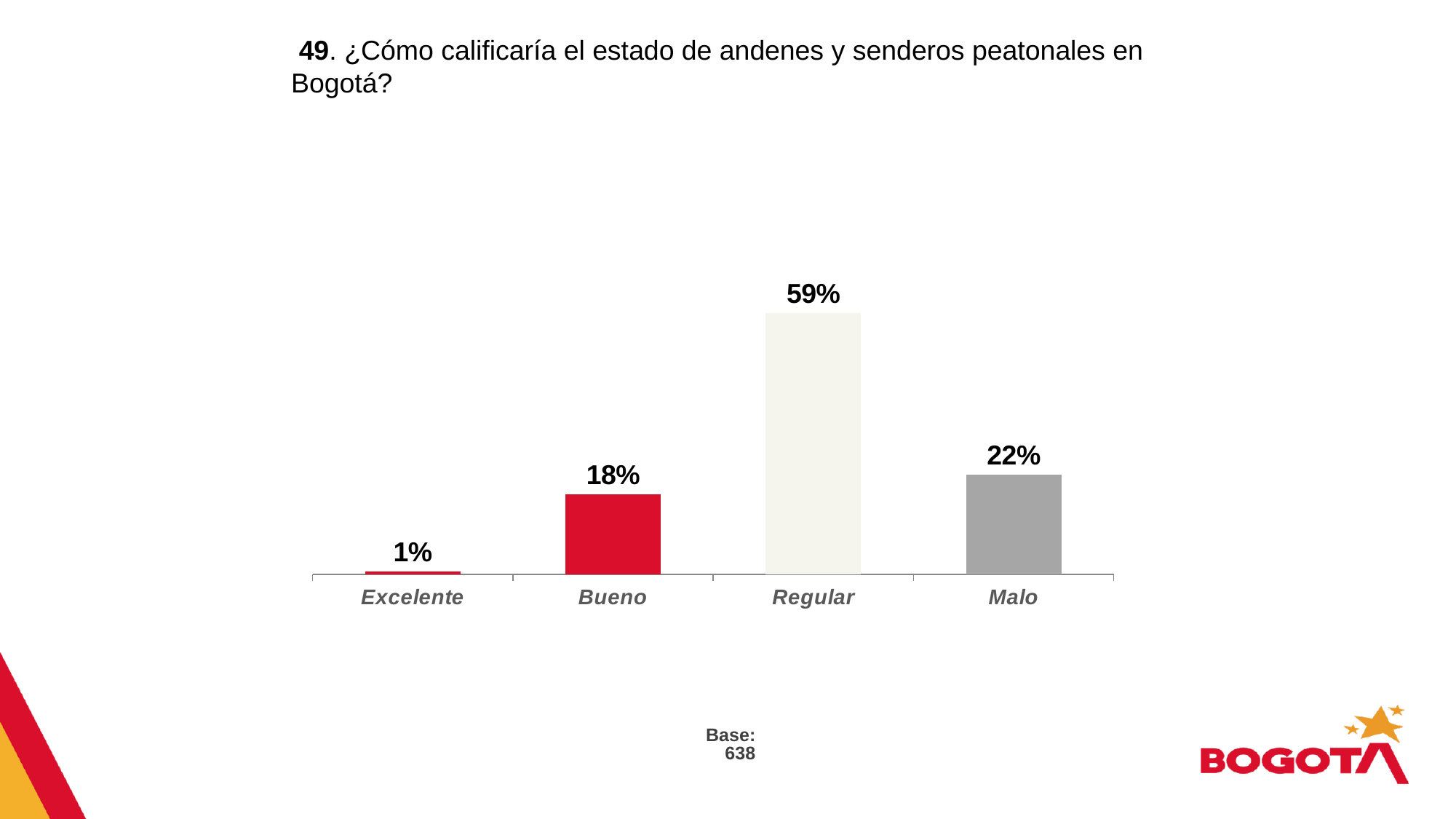
Which category has the lowest value? Excelente What is the value shown for Bueno? 18% What is the value shown for Excelente? 1% What kind of chart is shown on the slide? Bar chart Which category has the highest value? Regular What is the difference between the values for Regular and Malo? 37% What is the difference between the values for Malo and Bueno? 4% What is the value shown for Malo? 22% How many categories are shown on the chart? 4 What percentage of respondents rated the state of sidewalks and pedestrian paths as Regular? 59% What is the base (number of respondents) shown below the chart? 638 Which is larger, the value for Bueno or the value for Malo? Malo